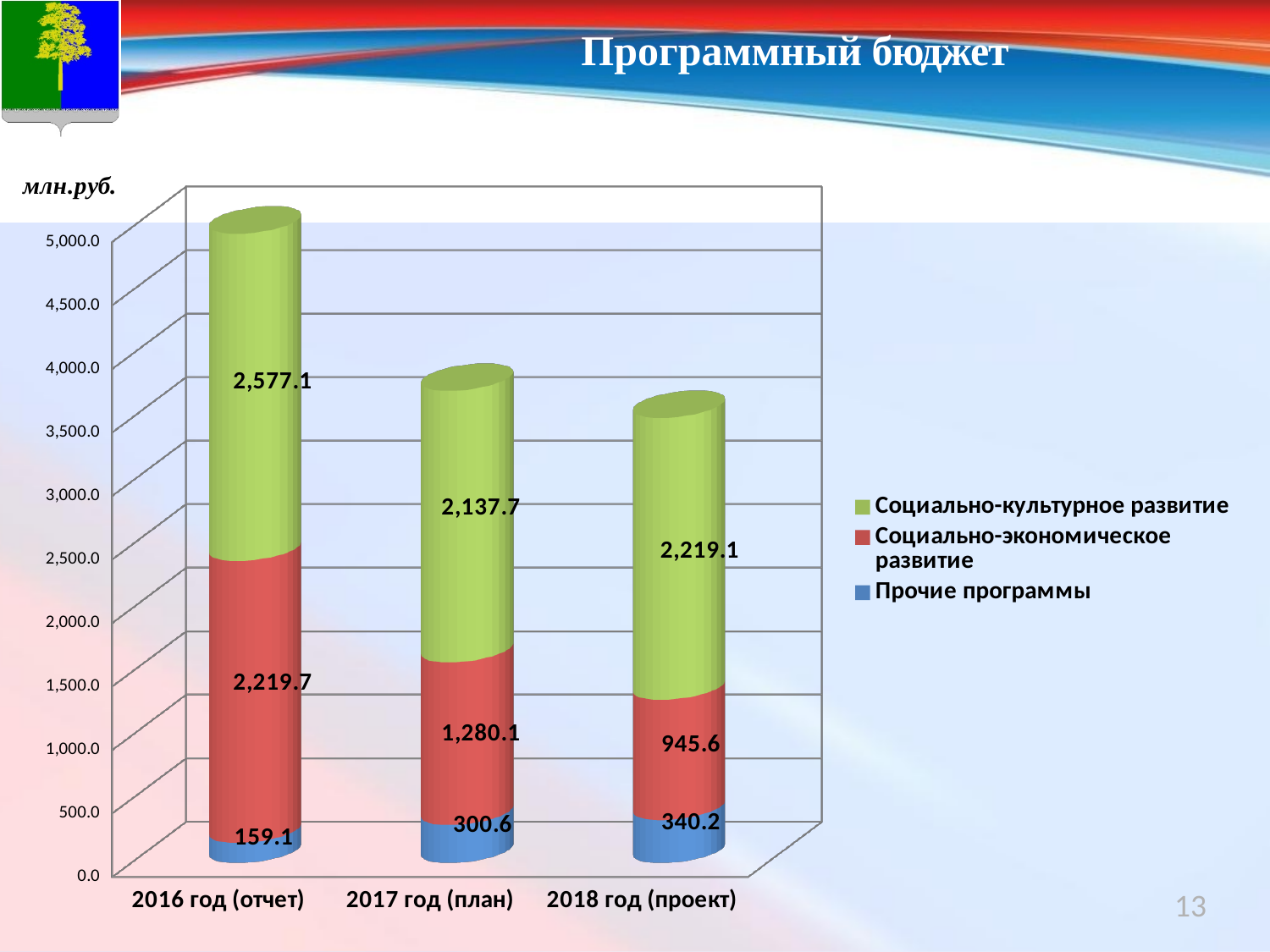
How many series does the legend list? 3 What is the difference between the Социально-экономическое развитие values for 2016 год (отчет) and 2017 год (план)? 939.6 What is the value for Социально-культурное развитие in 2016 год (отчет)? 2,577.1 In which year is the value for Социально-экономическое развитие the lowest? 2018 год (проект) How many years (categories) are shown on the x axis? 3 Do the total bar heights rise or fall from 2016 to 2018? fall What is the total of the stacked bar for 2016 год (отчет)? 4,955.9 What is the total of the stacked bar for 2018 год (проект)? 3,504.9 In which year is the value for Прочие программы the highest? 2018 год (проект) What is the value for Прочие программы in 2018 год (проект)? 340.2 What is the value for Социально-экономическое развитие in 2017 год (план)? 1,280.1 Which is larger: Социально-культурное развитие in 2017 год (план) or in 2018 год (проект)? 2018 год (проект)